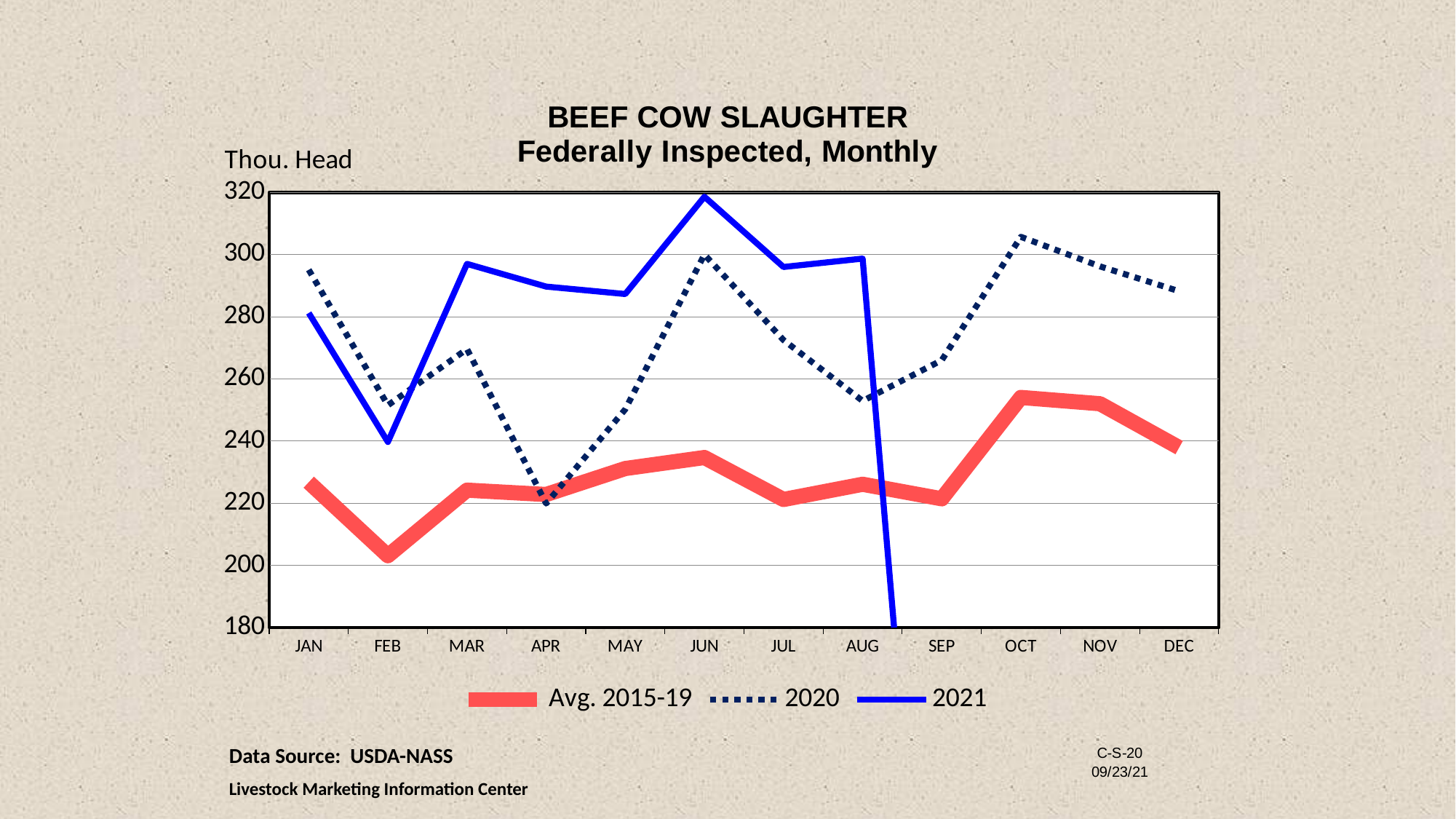
What kind of chart is shown on the slide? line chart How many months are shown along the x axis? 12 In JAN, which series has the larger value, 2020 or 2021? 2020 In which month is the Avg. 2015-19 series at its lowest? FEB Is the Avg. 2015-19 value for FEB greater or less than 220? less Is the 2021 value for JUN greater or less than 300? greater What unit label is shown above the y axis? Thou. Head In which month does the 2020 series reach its lowest value? APR Is the 2020 value for APR greater or less than 240? less In which month does the 2021 series reach its highest value? JUN In MAR, which series has the larger value, 2020 or 2021? 2021 How many series does the legend list? 3